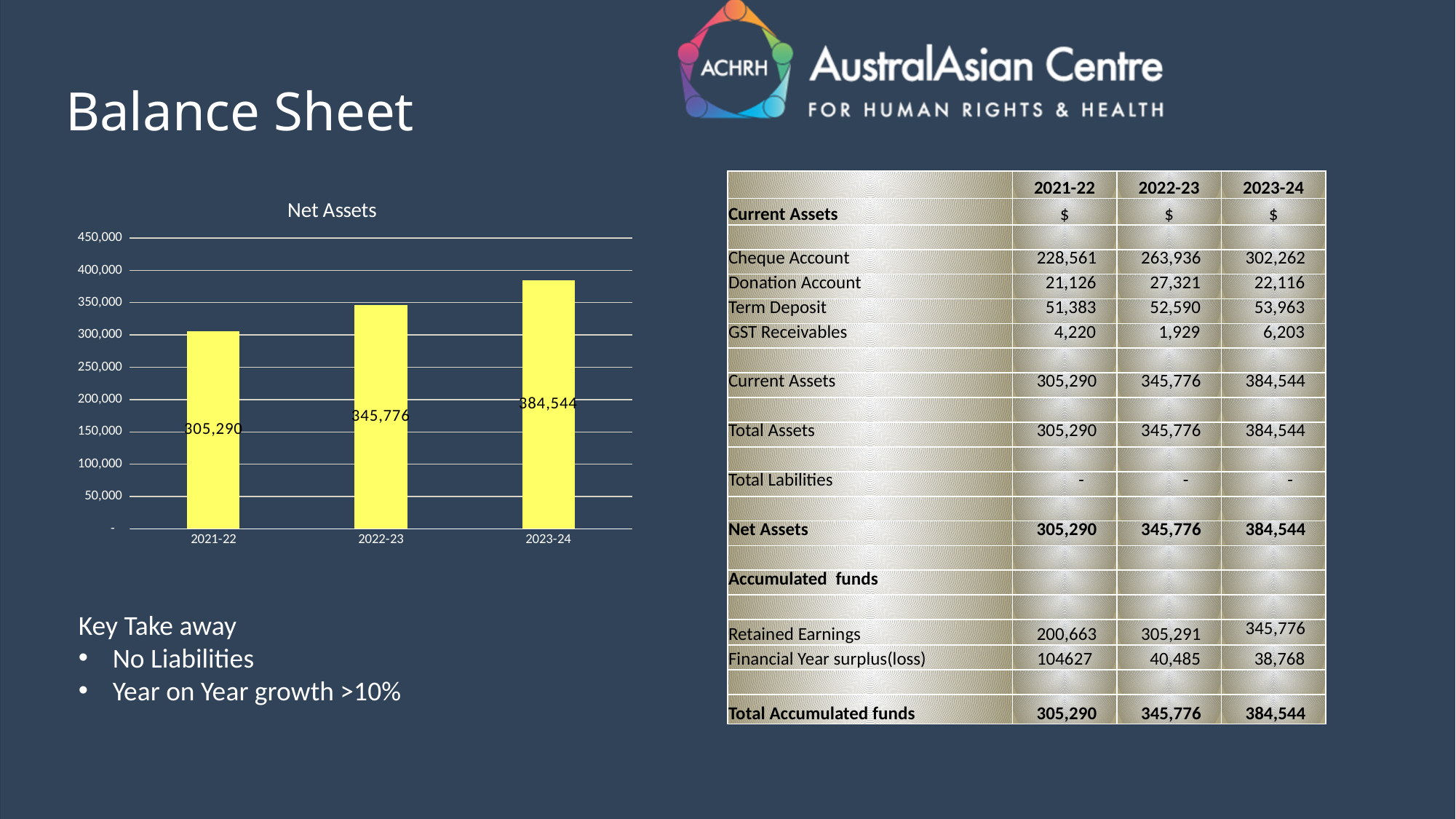
What is the difference in Net Assets between 2023-24 and 2022-23? 38,768 Which year has the lowest Net Assets in the chart? 2021-22 What is the Net Assets value for 2022-23 in the chart? 345,776 Which year has the highest Net Assets in the chart? 2023-24 How many years are shown in the Net Assets chart? 3 What is the difference in Net Assets between 2022-23 and 2021-22? 40,486 Which is larger, the Net Assets for 2021-22 or for 2023-24? 2023-24 What type of chart is used to show Net Assets? bar chart What is the Net Assets value for 2021-22 in the chart? 305,290 Is the Net Assets value for 2023-24 greater or less than 400,000? less What is the Net Assets value for 2023-24 in the chart? 384,544 Do the Net Assets values rise or fall from 2021-22 to 2023-24? rise